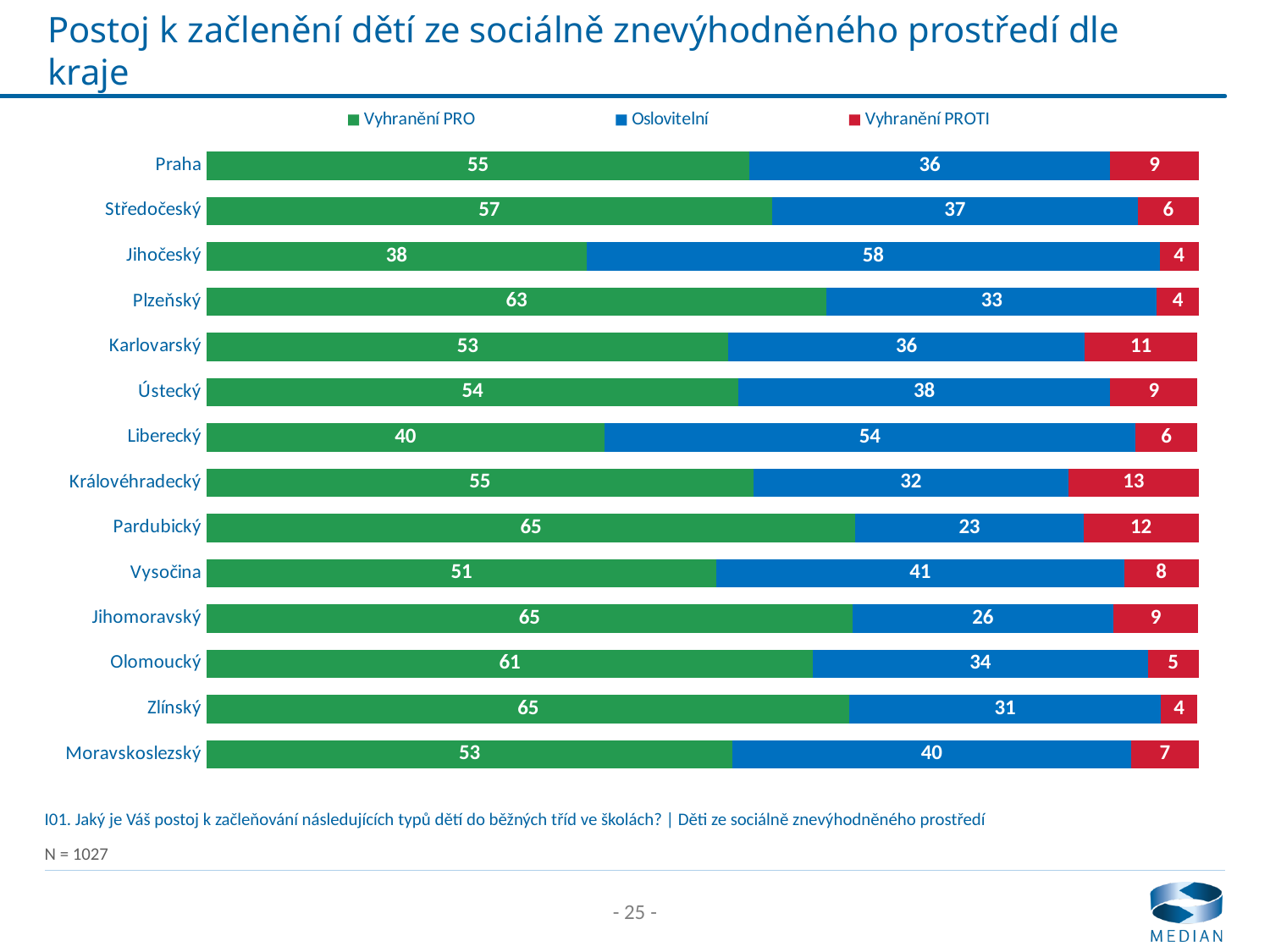
How many series does the legend list? 3 What is the Oslovitelní value for Jihočeský? 58 Which is larger, the Oslovitelní value for Liberecký or for Moravskoslezský? Liberecký What is the difference between the Vyhranění PRO values for Pardubický and Vysočina? 14 How many regions are shown in the chart? 14 Which region has the lowest Oslovitelní value? Pardubický Which region has the highest Vyhranění PROTI value? Královéhradecký Which region has the lowest Vyhranění PRO value? Jihočeský What is the Vyhranění PROTI value for Karlovarský? 11 What kind of chart is shown on the slide? Stacked bar chart What is the Vyhranění PRO value for Plzeňský? 63 What is the total of the stacked bar for Královéhradecký? 100